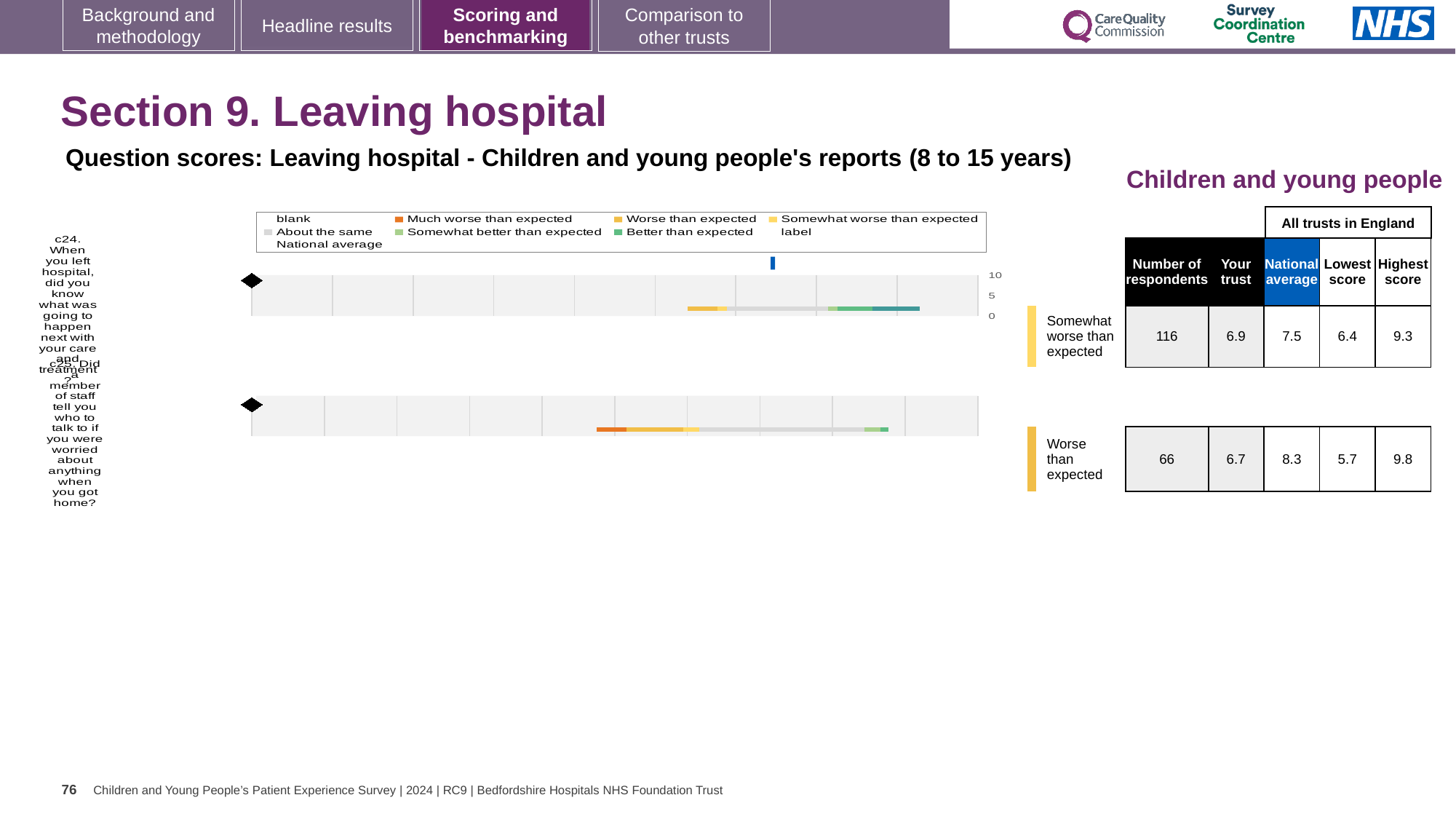
What kind of chart is used to show the question scores for c24 and c25? bar chart What is the national average score for question c24? 7.5 How many respondents answered question c24? 116 For question c25, what is the difference between the national average and the 'Your trust' score? 1.6 What is the national average score for question c25? 8.3 What is the highest score among all trusts in England for question c25? 9.8 Which benchmark category is question c24 placed in? Somewhat worse than expected For question c24 (did you know what was going to happen next with your care and treatment), what is the 'Your trust' score? 6.9 How many questions (c24 and c25) are plotted on the slide? 2 Which benchmark category is question c25 placed in? Worse than expected For question c25 (did a member of staff tell you who to talk to if you were worried), what is the 'Your trust' score? 6.7 Which question has the higher 'Your trust' score, c24 or c25? c24